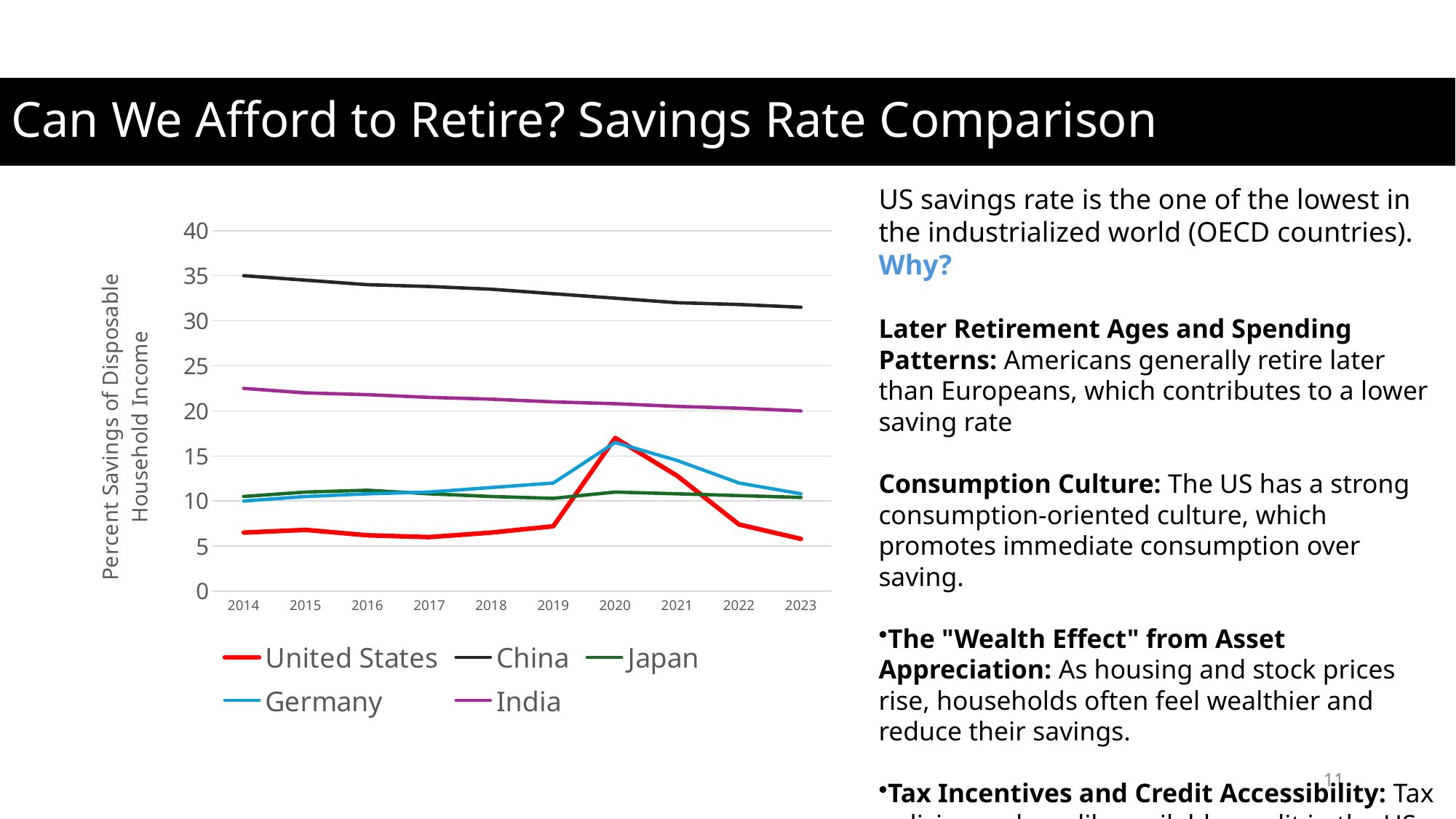
What colour is the United States line? red What is the label on the y axis? Percent Savings of Disposable Household Income Is the value for China in 2014 greater or less than 30? greater Is the value for the United States in 2017 greater or less than 10? less Does the China line rise or fall from 2014 to 2023? fall What kind of chart is shown on the slide? line chart Which country has the lowest savings rate in 2023? United States How many years are shown on the x axis? 10 How many series does the legend list? 5 Is the value for India in 2023 greater or less than 25? less In 2022, which is larger, the value for Germany or the value for Japan? Germany Which country has the highest savings rate in 2014? China